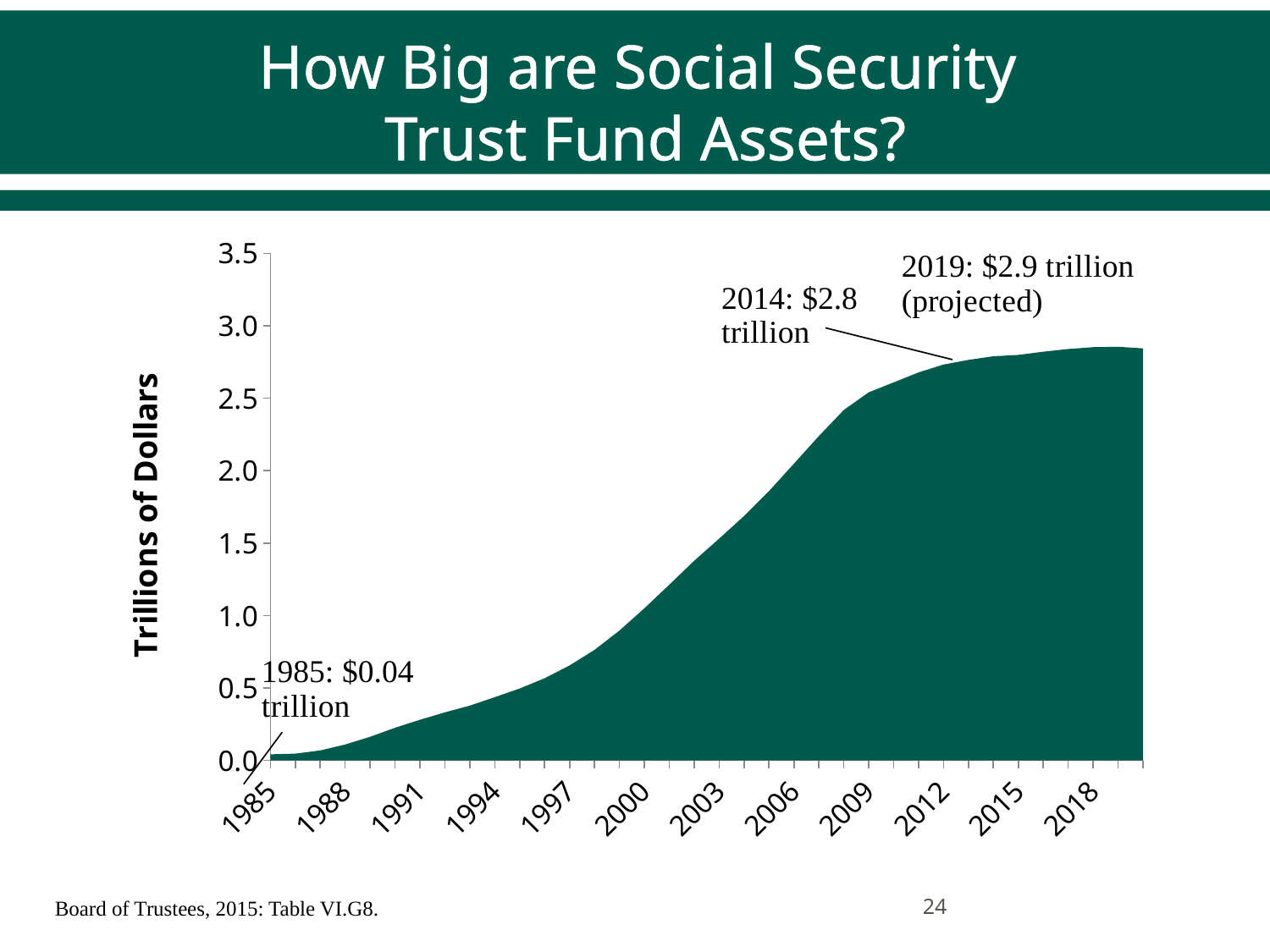
Is the value for 2006 greater or less than 1.5 trillion dollars? greater Do Trust Fund assets generally rise or fall from 1985 to 2018 along the x axis? Rise Of the three annotated years (1985, 2014, 2019), which has the highest value? 2019 What is the label on the vertical axis of the chart? Trillions of Dollars What is the projected value of Trust Fund assets for 2019 shown on the chart? $2.9 trillion Is the value for 2012 greater or less than 2.5 trillion dollars? greater By how much do the annotated assets increase from 2014 to the projected 2019 value? $0.1 trillion What were Social Security Trust Fund assets in 1985 according to the chart annotation? $0.04 trillion Which annotated year has the larger value, 1985 or 2014? 2014 What were Social Security Trust Fund assets in 2014 according to the chart annotation? $2.8 trillion What kind of chart is shown on the slide? Area chart Is the value for 1991 greater or less than 0.5 trillion dollars? less